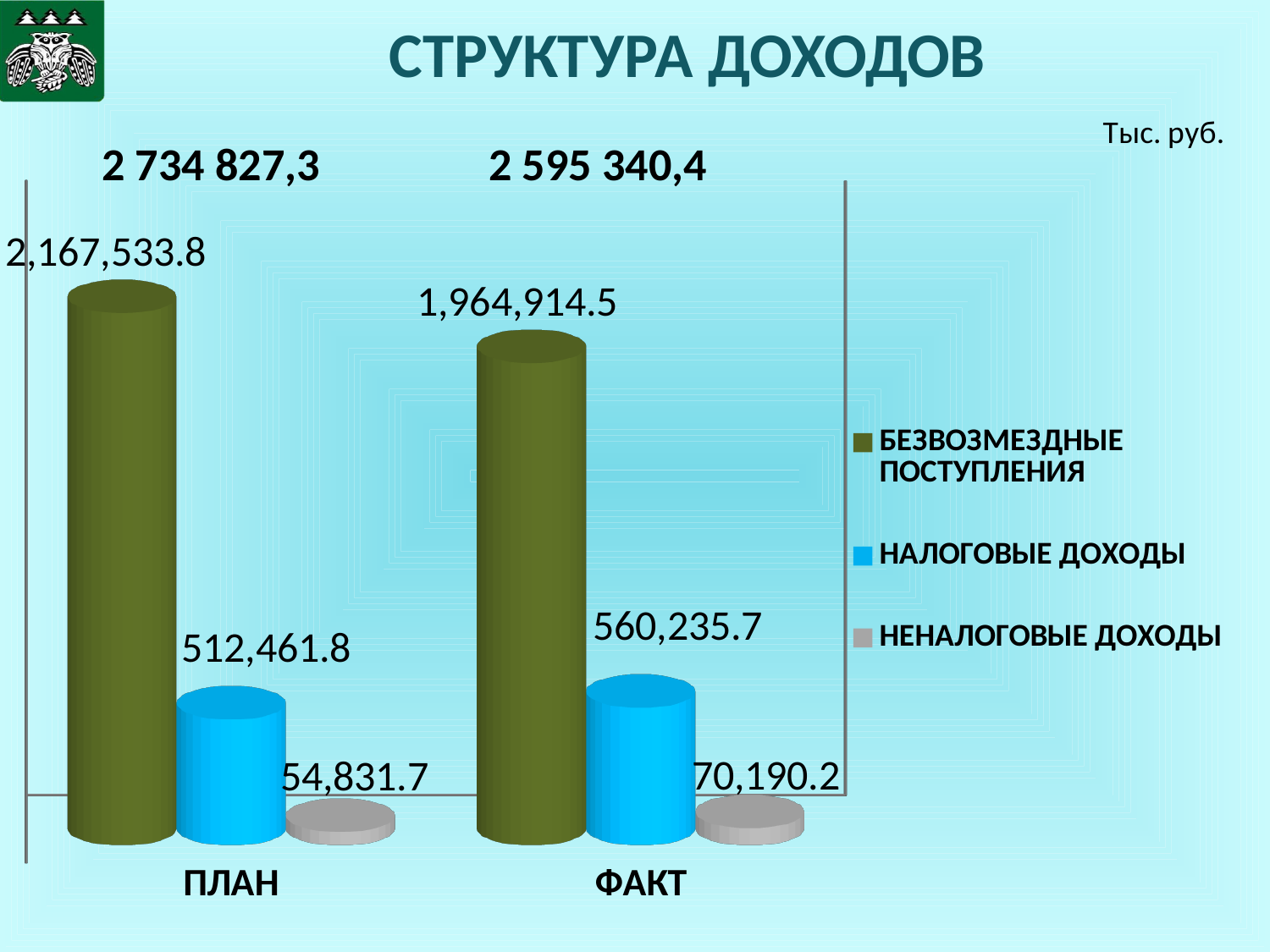
What is the value of БЕЗВОЗМЕЗДНЫЕ ПОСТУПЛЕНИЯ for ПЛАН? 2,167,533.8 Which is larger: НЕНАЛОГОВЫЕ ДОХОДЫ for ПЛАН or for ФАКТ? ФАКТ What is the difference between the ПЛАН and ФАКТ values for БЕЗВОЗМЕЗДНЫЕ ПОСТУПЛЕНИЯ? 202,619.3 Which series has the highest value in the ФАКТ category? БЕЗВОЗМЕЗДНЫЕ ПОСТУПЛЕНИЯ What is the difference between the ФАКТ and ПЛАН values for НАЛОГОВЫЕ ДОХОДЫ? 47,773.9 How many categories are shown on the x axis? 2 What kind of chart is shown on the slide? Bar chart What is the value of БЕЗВОЗМЕЗДНЫЕ ПОСТУПЛЕНИЯ for ФАКТ? 1,964,914.5 What is the value of НАЛОГОВЫЕ ДОХОДЫ for ФАКТ? 560,235.7 Which series has the lowest value in the ПЛАН category? НЕНАЛОГОВЫЕ ДОХОДЫ What is the value of НЕНАЛОГОВЫЕ ДОХОДЫ for ПЛАН? 54,831.7 How many series does the legend list? 3